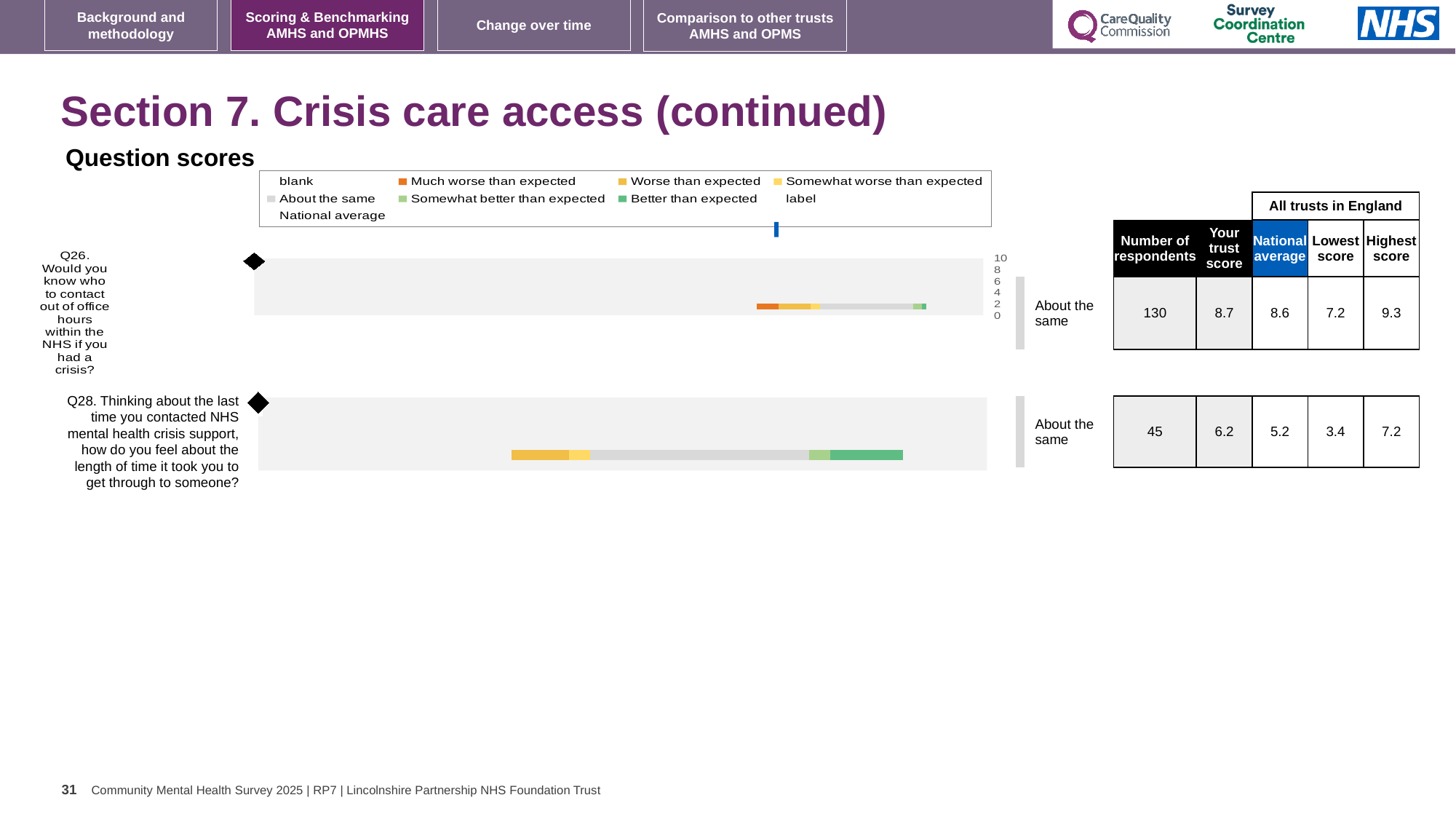
What is the difference between the trust score and the national average for Q28? 1.0 What is the highest score among all trusts in England for Q26? 9.3 What is the trust score for Q26 (knowing who to contact out of office hours in a crisis)? 8.7 Which question has the higher trust score, Q26 or Q28? Q26 How many respondents answered Q26? 130 What kind of chart is used to show the question scores for Q26 and Q28? Bar chart What is the difference between the highest and lowest scores across all trusts for Q26? 2.1 What is the trust score for Q28 (length of time to get through to crisis support)? 6.2 What colour does the legend use for 'Much worse than expected'? Orange What is the national average score for Q28? 5.2 What is the highest value shown on the chart's axis? 10 How many questions are plotted in the question scores chart? 2